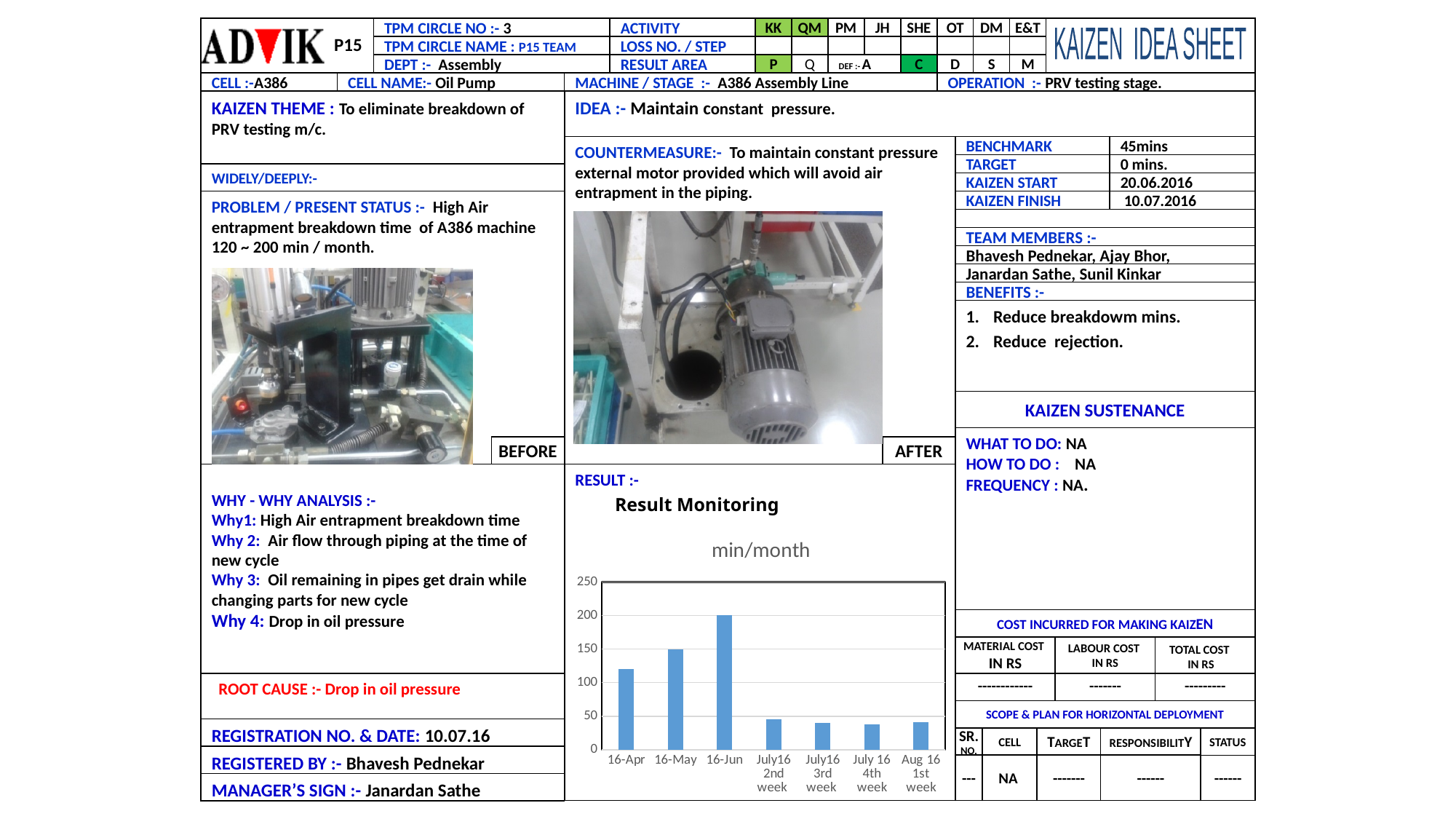
Do the values rise or fall from 16-Jun to July16 2nd week? fall Which category has the highest value in the Result Monitoring chart? 16-Jun What kind of chart is shown under Result Monitoring? bar chart What is the title shown above the Result Monitoring chart's plot area? min/month Which is larger, the value for 16-Apr or the value for 16-Jun? 16-Jun Is the value for July16 2nd week greater or less than 50? less Is the value for 16-Apr greater or less than 150? less Is the value for 16-Apr greater or less than 100? greater Which is larger, the value for 16-May or the value for July16 3rd week? 16-May How many categories are plotted on the x axis of the Result Monitoring chart? 7